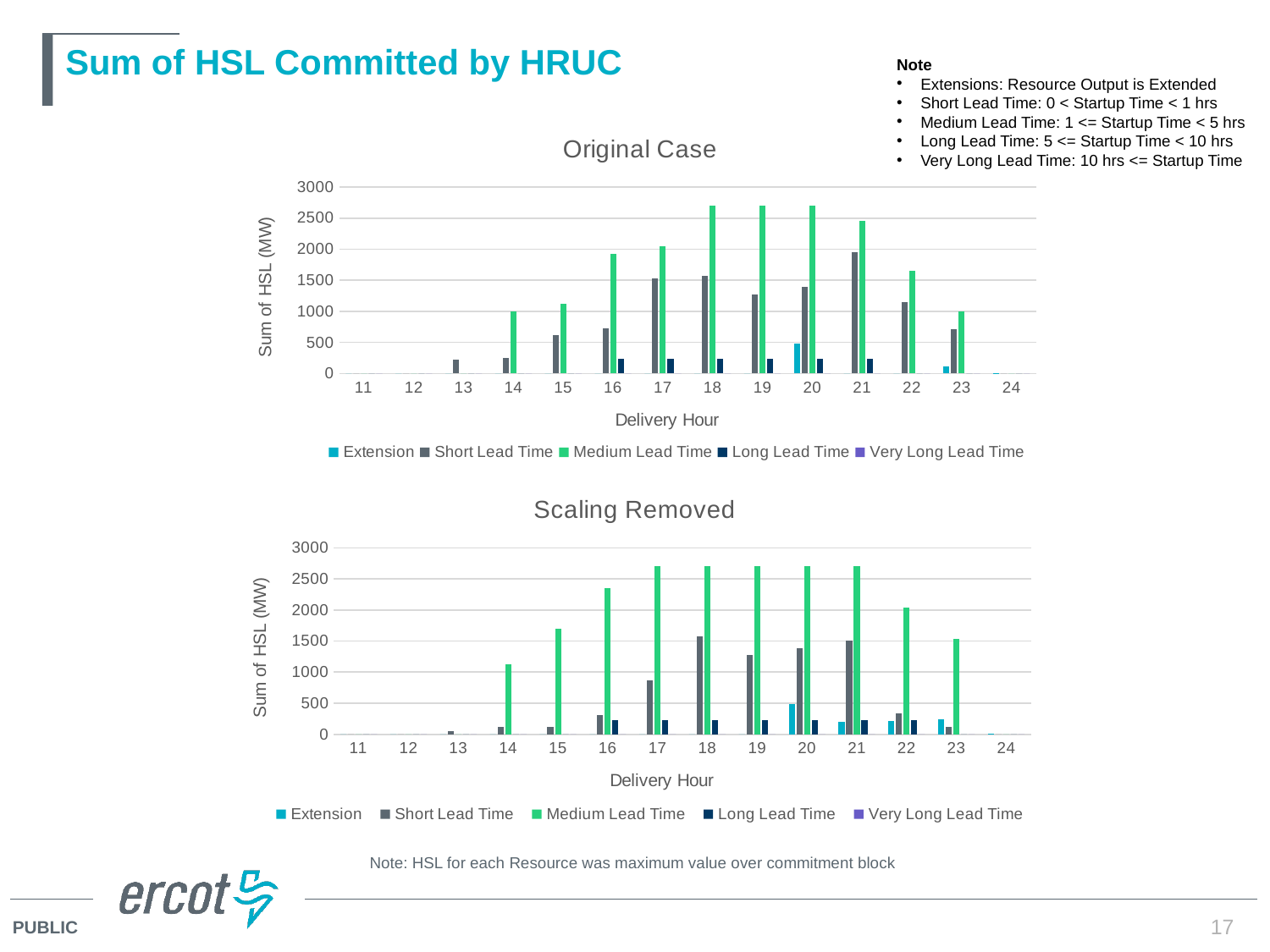
How many series does the legend of the "Scaling Removed" chart list? 5 In the "Original Case" chart, is the Medium Lead Time value at delivery hour 18 greater or less than 2500? greater In the "Original Case" chart, at delivery hour 17, which is larger: Medium Lead Time or Short Lead Time? Medium Lead Time What kind of chart is the "Original Case" chart? bar chart How many delivery hours are shown on the x axis of the "Original Case" chart? 14 In the "Original Case" chart, is the Short Lead Time value at delivery hour 21 greater or less than 1500? greater In the "Scaling Removed" chart, at delivery hour 22, which is larger: Medium Lead Time or Short Lead Time? Medium Lead Time In the "Scaling Removed" chart, is the Medium Lead Time value at delivery hour 16 greater or less than 2000? greater In the "Original Case" chart, at which delivery hour is the Short Lead Time value highest? 21 What is the y-axis label of the "Scaling Removed" chart? Sum of HSL (MW)